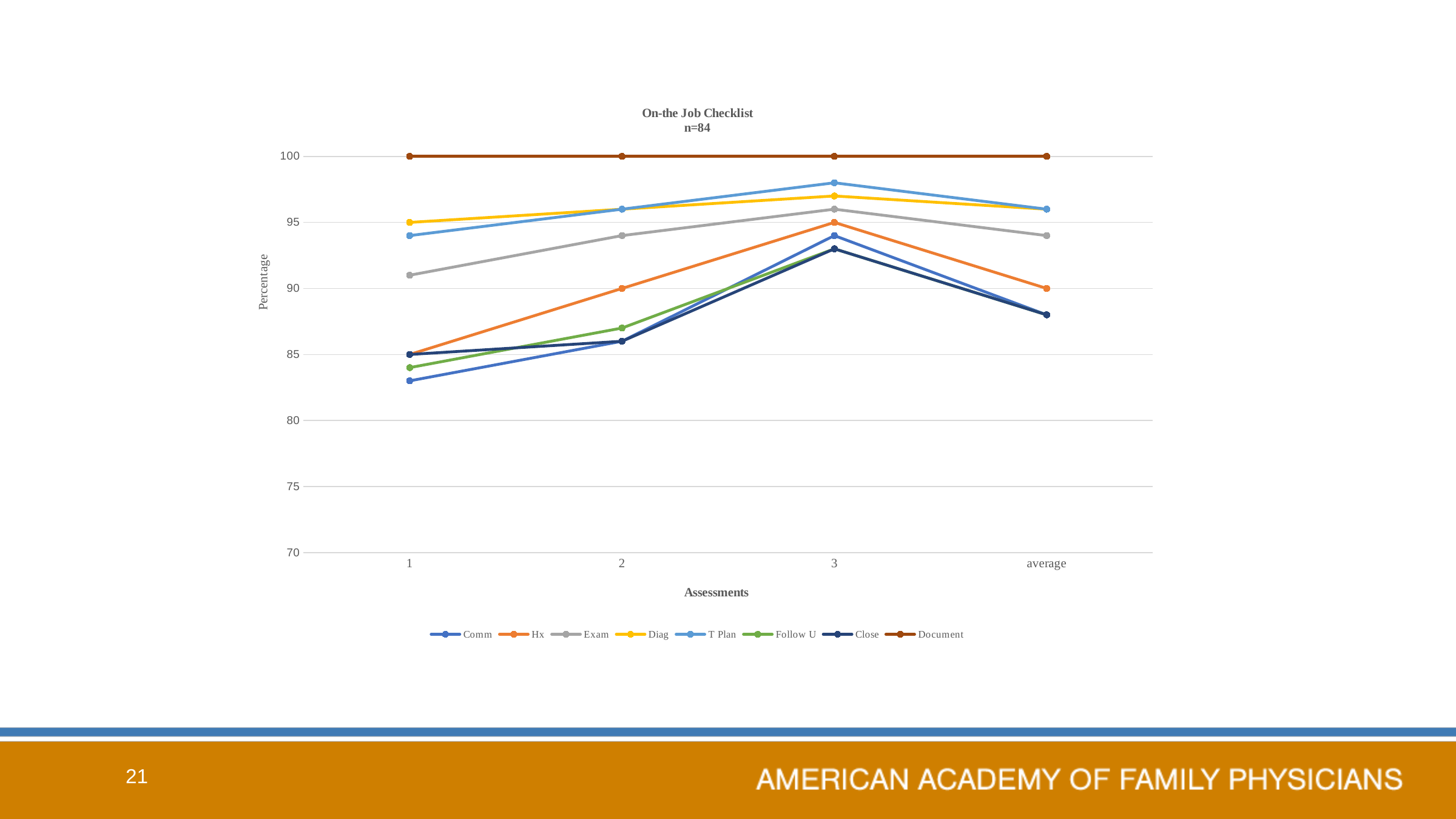
What is the value for Hx at assessment 2? 90 What is the value for Document at assessment 1? 100 Which series has the highest value at assessment 1? Document Does the Hx series rise or fall from assessment 1 to assessment 3? rise Which is larger at assessment 2, Exam or Hx? Exam What is the label on the y axis? Percentage What is the value for Diag at assessment 1? 95 How many categories are shown on the x axis? 4 How many series does the legend list? 8 What kind of chart is shown on the slide? line chart Is the value for Comm at assessment 1 greater or less than 85? less Is the value for T Plan at assessment 3 greater or less than 95? greater